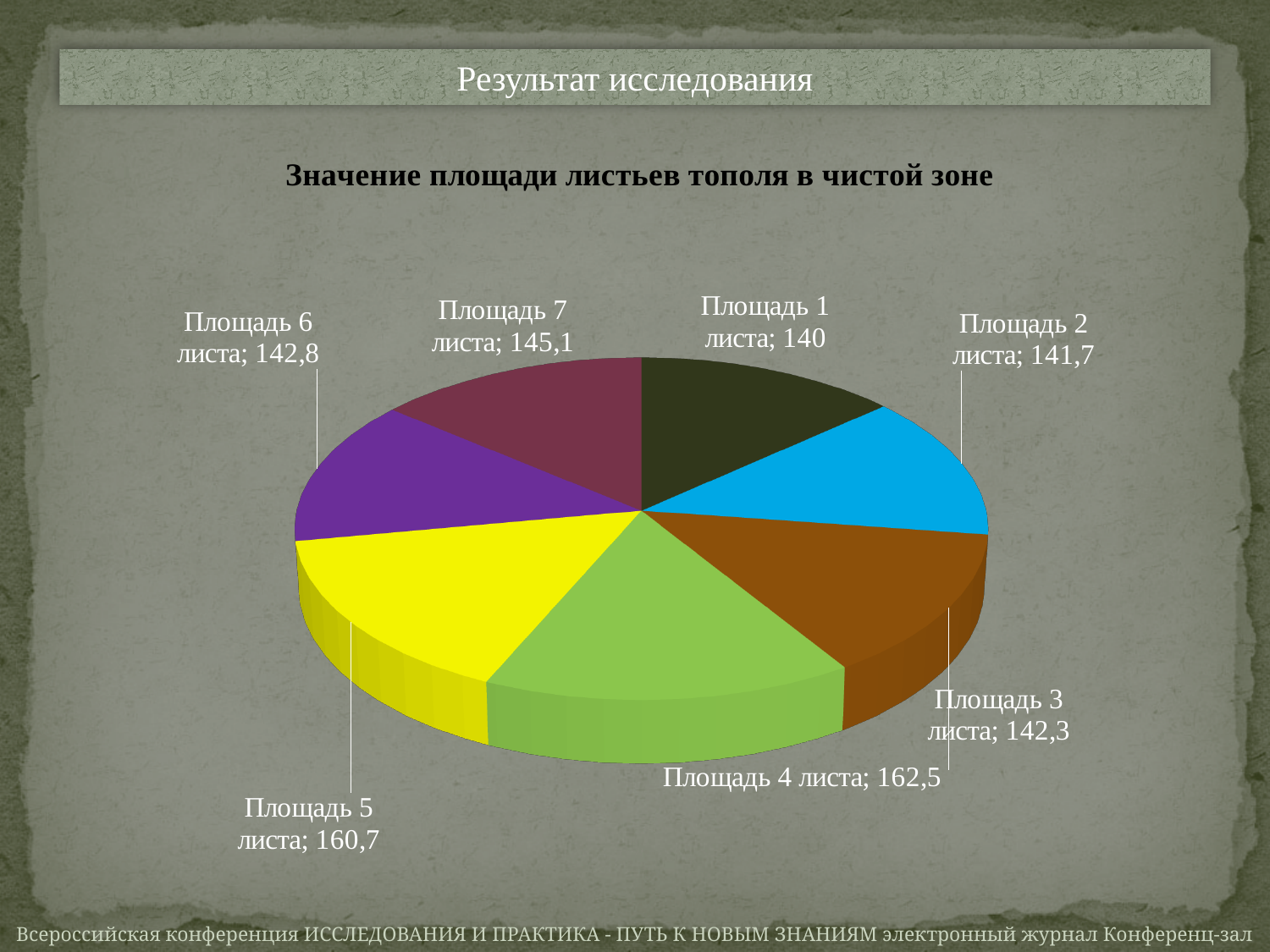
What is the value for Площадь 1 листа? 140 How many categories (slices) does the chart have? 7 What is the value for Площадь 6 листа? 142,8 What is the value for Площадь 7 листа? 145,1 What kind of chart is shown on the slide? Pie chart Which category has the highest value? Площадь 4 листа What is the difference between the values for Площадь 7 листа and Площадь 1 листа? 5,1 What is the title of the chart? Значение площади листьев тополя в чистой зоне What is the value for Площадь 4 листа? 162,5 What is the difference between the values for Площадь 4 листа and Площадь 5 листа? 1,8 Which is larger, the value for Площадь 6 листа or Площадь 3 листа? Площадь 6 листа Which category has the lowest value? Площадь 1 листа